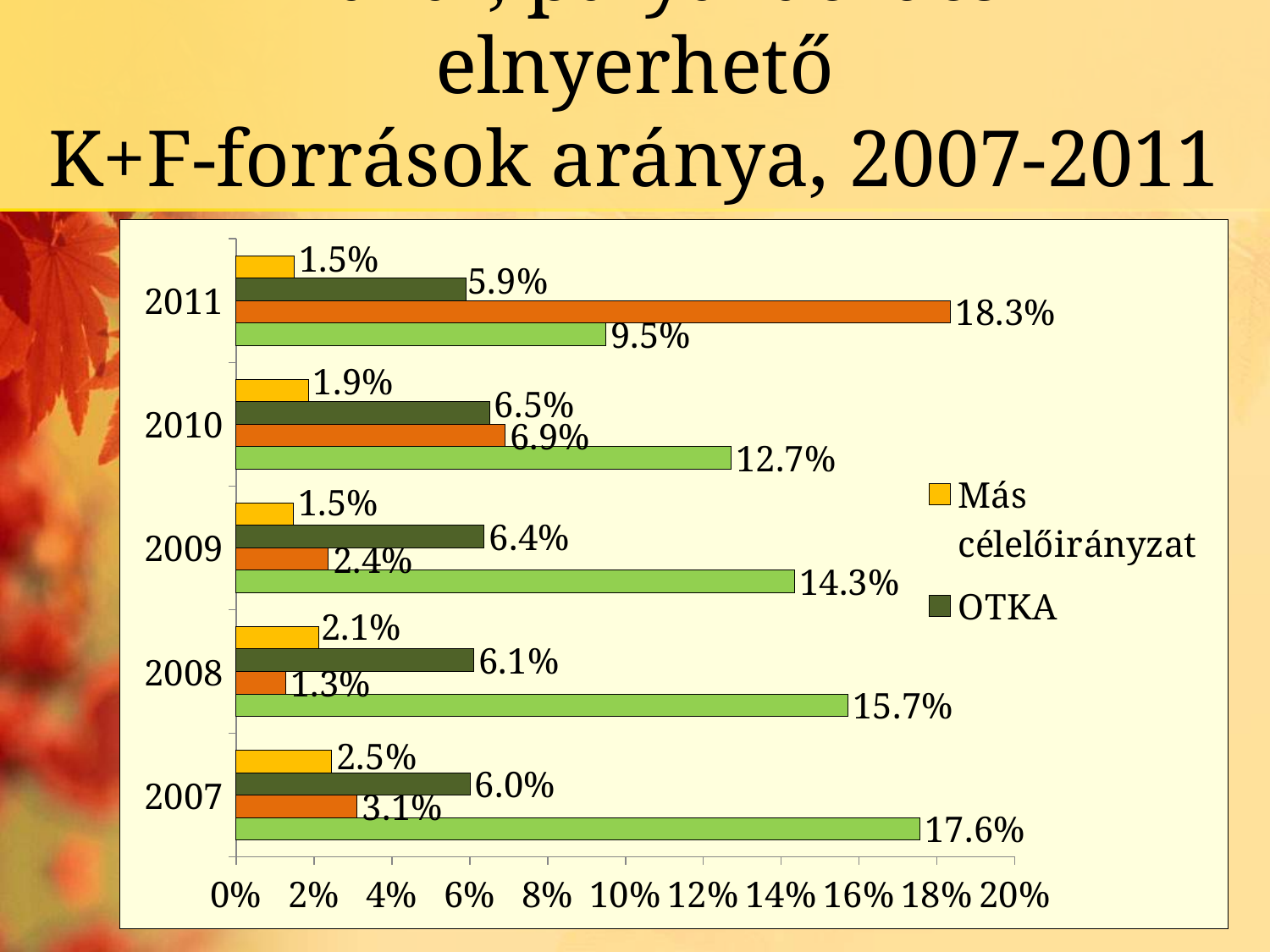
How many years are shown on the chart? 5 What is the OTKA value for 2011? 5.9% In which year is the OTKA value highest? 2010 Which is larger in 2008, the OTKA value or the Más célelőirányzat value? OTKA In which year is the Más célelőirányzat value highest? 2007 Is the OTKA value for 2009 greater or less than 4%? greater What kind of chart is shown on the slide? bar chart What is the OTKA value for 2010? 6.5% What is the value for Más célelőirányzat in 2007? 2.5% What is the difference between the Más célelőirányzat values for 2007 and 2011? 1.0% What colour represents OTKA in the legend? dark green How many bars are shown for each year? 4